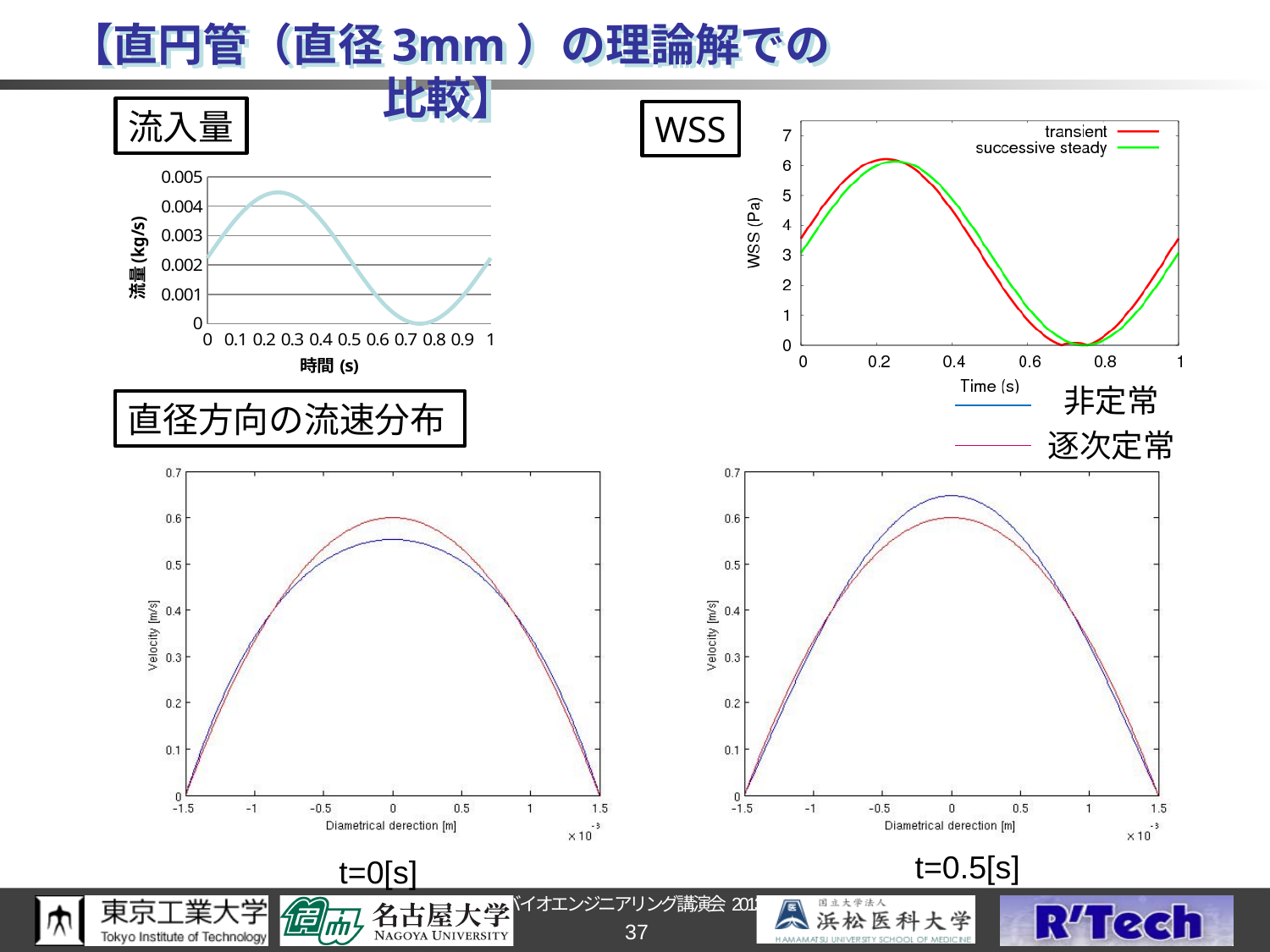
What is the x-axis label of the WSS chart? Time (s) In the WSS chart, is the transient value at 0.7 s greater or less than 1? less In the WSS chart, is the transient value at 0.2 s greater or less than 5? greater What is the y-axis label of the 流入量 chart? 流量 (kg/s) How many series does the legend of the WSS chart list? 2 In the velocity distribution chart for t=0.5[s], is the peak of the blue (非定常) curve greater or less than 0.6? greater In the 流入量 chart, does the flow rate rise or fall between 0.3 s and 0.7 s? fall What kind of chart is the 流入量 chart at the top left? line chart In the WSS chart, at time 0, which series has the higher value, transient or successive steady? transient In the velocity distribution chart for t=0[s], which curve has the higher peak velocity at the centre, the blue (非定常) or the red (逐次定常)? red (逐次定常)